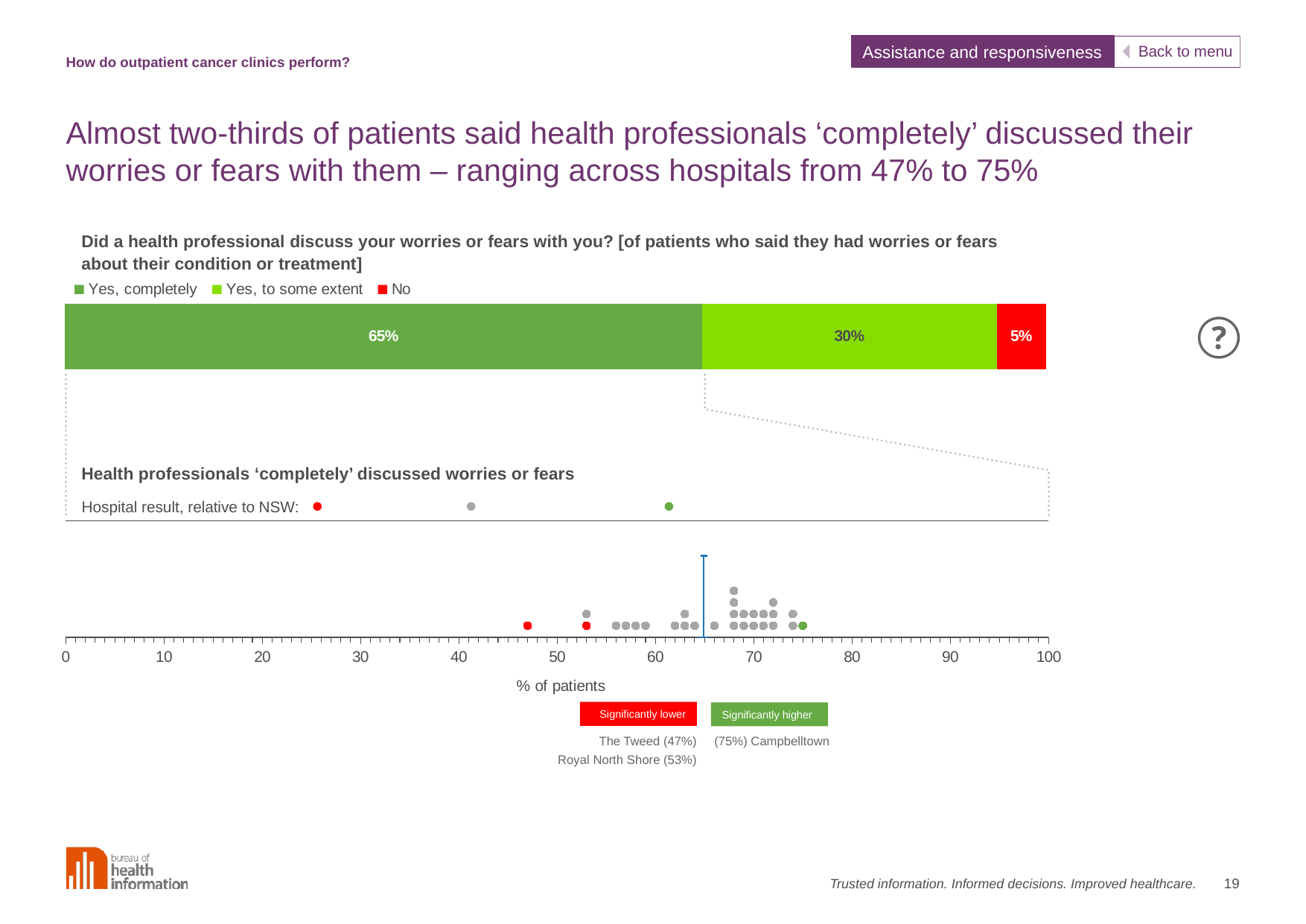
In the dot plot of hospital results, what is the result for The Tweed? 47% In the stacked bar chart, which response category has the smallest share? No In the stacked bar chart, which response category has the largest share? Yes, completely In the stacked bar chart, what percentage of patients answered 'No'? 5% In the dot plot of hospital results, which hospital has the higher result, Royal North Shore or The Tweed? Royal North Shore In the stacked bar chart, how many percentage points higher is 'Yes, completely' than 'Yes, to some extent'? 35 percentage points In the dot plot of hospital results, how many hospitals are labelled as significantly lower than NSW? 2 How many response categories does the legend of the stacked bar chart list? 3 In the dot plot of hospital results, what is the result for Campbelltown? 75% In the stacked bar chart, what percentage of patients said a health professional 'Yes, completely' discussed their worries or fears? 65% In the stacked bar chart, what percentage of patients answered 'Yes, to some extent'? 30% What kind of chart is the top chart showing the 65%, 30% and 5% segments? Stacked bar chart